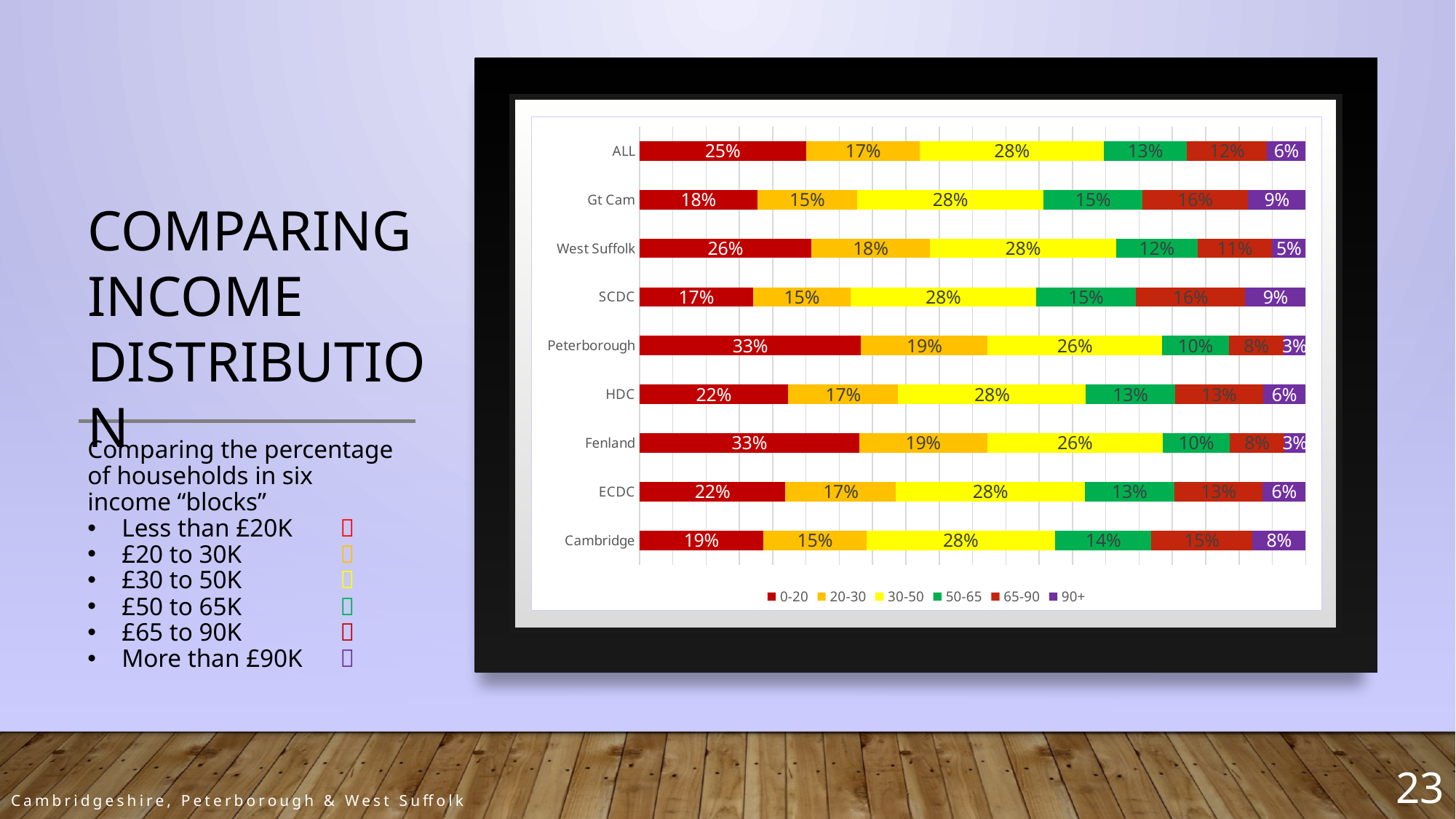
What percentage of households in Peterborough are in the 30-50 block? 26% What is the value of the 90+ series for Gt Cam? 9% Which is larger: the 0-20 value for West Suffolk or the 0-20 value for HDC? West Suffolk Which area has the lowest value in the 0-20 series? SCDC How many areas (categories) are shown on the chart? 9 What colour represents the 30-50 income block in the chart? Yellow What is the difference between the 0-20 value for ALL and the 0-20 value for Cambridge? 6 percentage points How many series does the legend list? 6 What percentage of households in Cambridge fall in the 0-20 income block? 19% What is the 65-90 value for West Suffolk? 11% What kind of chart is shown on the slide? Stacked bar chart What is the 50-65 value for ECDC? 13%